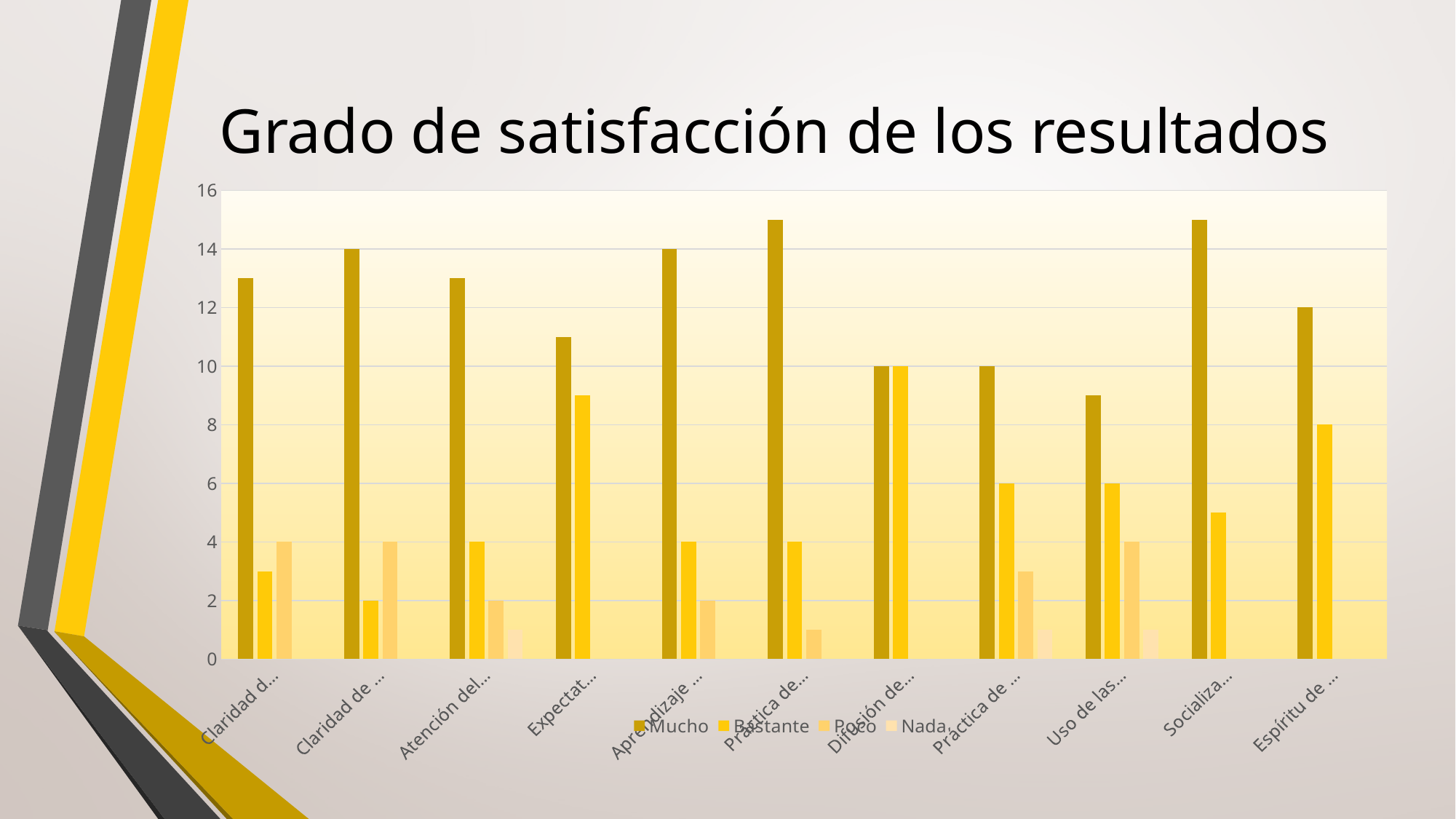
What is the value of the Mucho series for the category 'Espíritu de ...'? 12 What is the value of the Bastante series for the category 'Uso de las...'? 6 How many series does the legend list? 4 What kind of chart is shown on the slide? bar chart Is the Mucho value for 'Socializa...' greater or less than 14? greater For the category 'Espíritu de ...', what is the difference between the Mucho value and the Bastante value? 4 For the category 'Espíritu de ...', which is larger: the Mucho value or the Bastante value? Mucho What is the title of the chart? Grado de satisfacción de los resultados Which category has the lowest Mucho value? Uso de las... Which series is listed first in the legend? Mucho How many categories are plotted along the x axis? 11 Is the Mucho value for 'Uso de las...' greater or less than 10? less